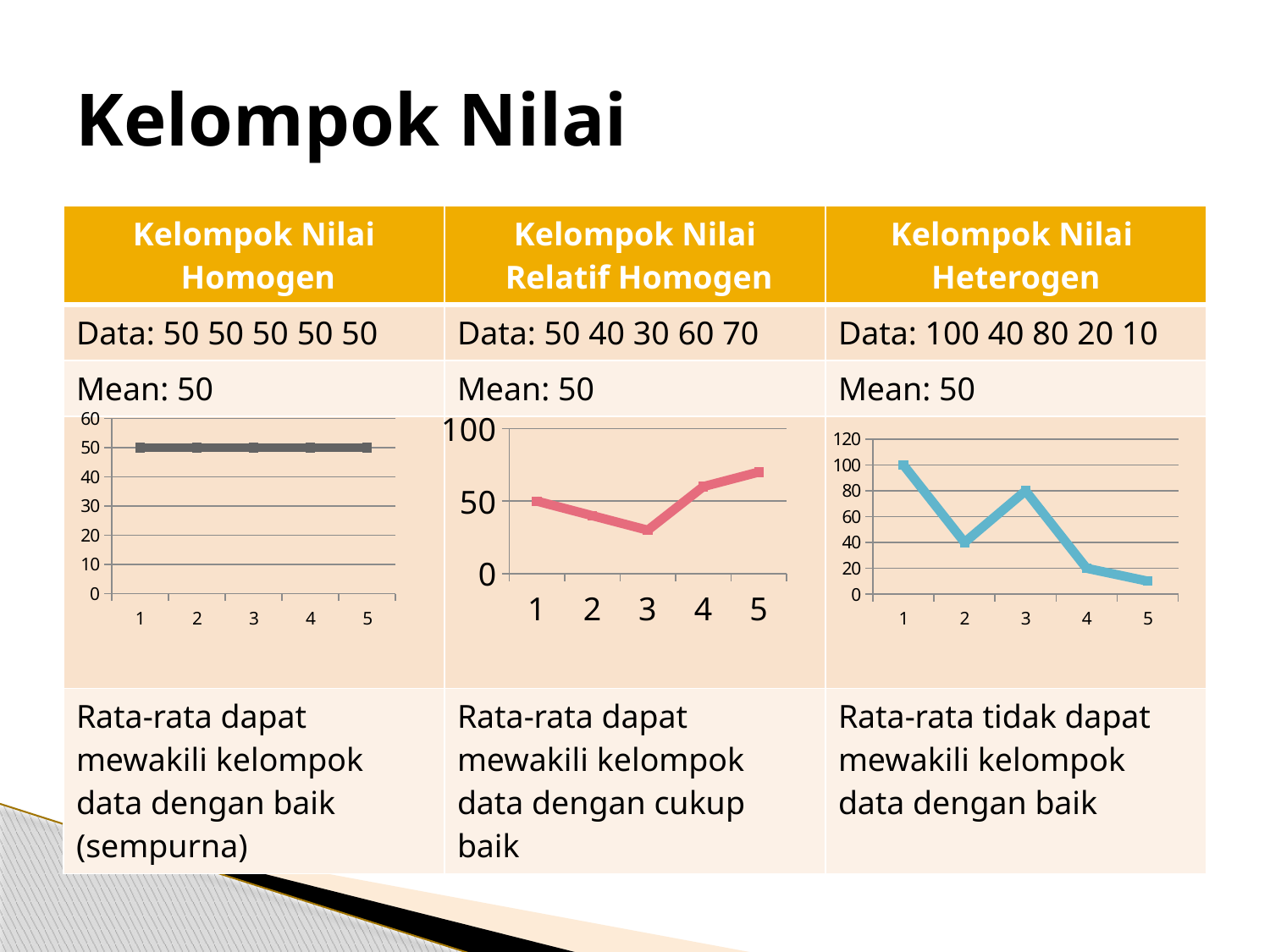
What is the maximum value shown on the vertical axis of the Kelompok Nilai Heterogen chart? 120 In the Kelompok Nilai Heterogen chart, which point has the highest value? 1 In the Kelompok Nilai Relatif Homogen chart, is the value at point 5 greater or less than 50? greater In the Kelompok Nilai Homogen chart, what is the value at point 3? 50 In the Kelompok Nilai Heterogen chart, is the value at point 5 greater or less than 20? less In the Kelompok Nilai Relatif Homogen chart, do the values rise or fall from point 3 to point 5? rise In the Kelompok Nilai Heterogen chart, which is larger: the value at point 2 or the value at point 3? point 3 In the Kelompok Nilai Heterogen chart, what is the value at point 1? 100 How many data points are plotted in the Kelompok Nilai Homogen chart? 5 What kind of chart is shown in the Kelompok Nilai Heterogen column? line chart In the Kelompok Nilai Relatif Homogen chart, which point has the lowest value? 3 In the Kelompok Nilai Heterogen chart, what is the difference between the values at point 1 and point 5? 90